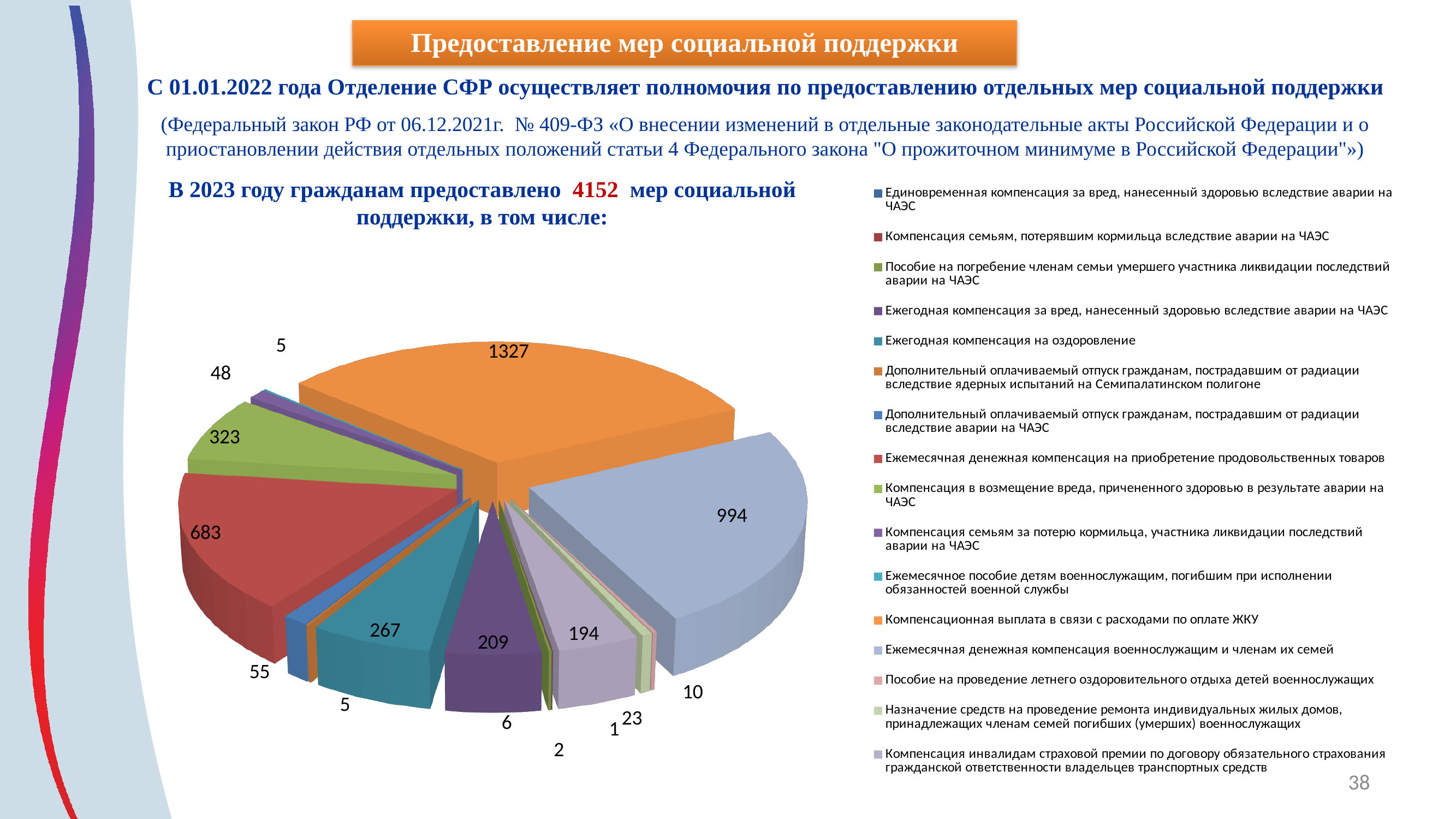
What is the value of the slice for «Ежегодная компенсация на оздоровление»? 267 What is the difference between the two largest slices, 1327 and 994? 333 What kind of chart is shown on the slide? Pie chart What is the largest value shown on the pie chart? 1327 What total number of social support measures provided in 2023 is stated above the chart? 4152 How many entries does the legend of the pie chart list? 16 Which slice is larger: the one labelled 683 or the one labelled 323? 683 What is the value of the slice for «Ежемесячная денежная компенсация на приобретение продовольственных товаров»? 683 What is the value of the slice for «Компенсационная выплата в связи с расходами по оплате ЖКУ»? 1327 How many slices does the pie chart have? 16 What is the smallest value shown on the pie chart? 1 What is the value of the slice for «Ежемесячная денежная компенсация военнослужащим и членам их семей»? 994